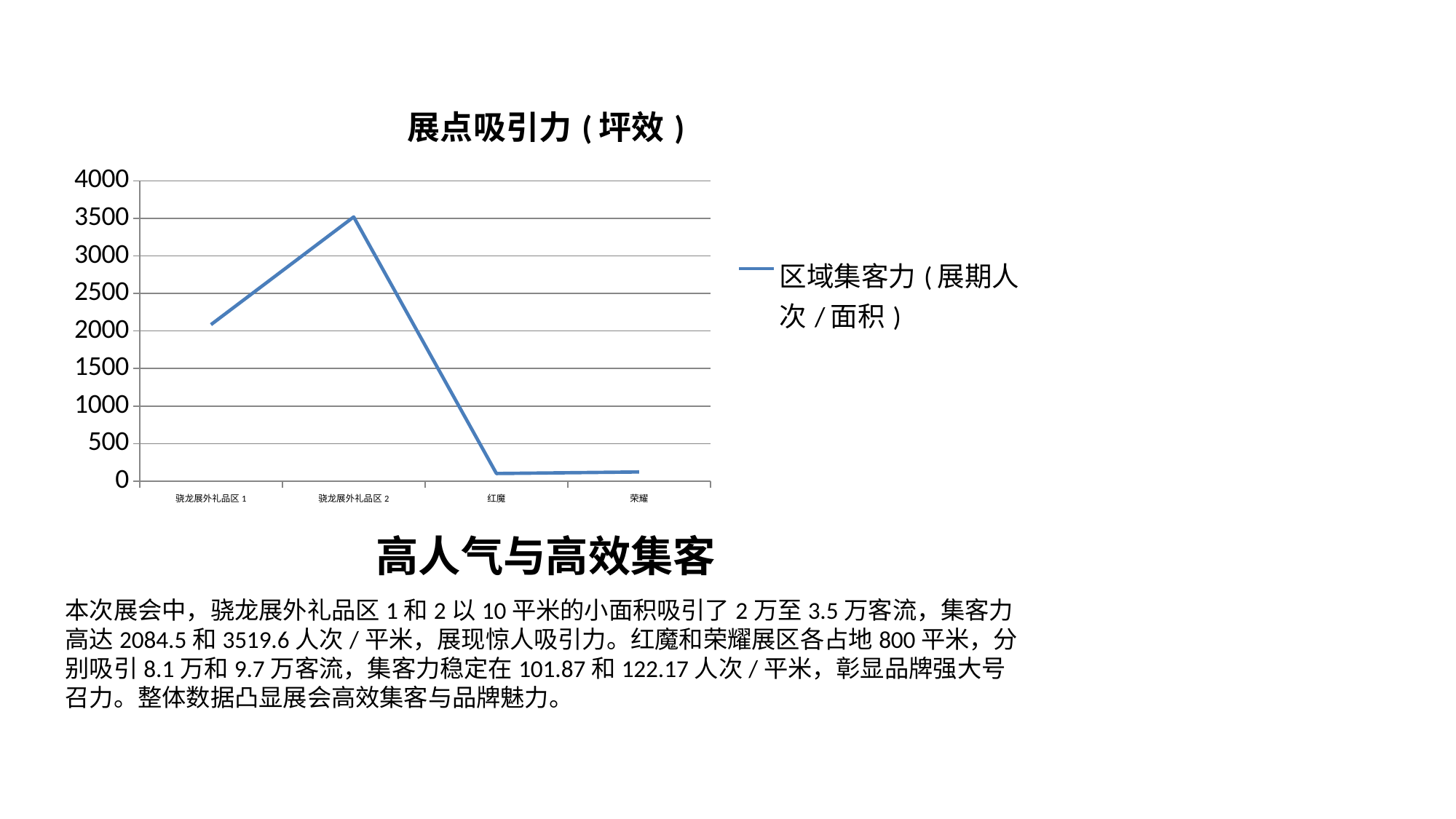
Is the value for 荣耀 greater or less than 1000? less What is the legend entry for the plotted series? 区域集客力（展期人次／面积） Is the value for 骁龙展外礼品区 1 greater or less than 1500? greater Which is larger, the value for 骁龙展外礼品区 1 or 骁龙展外礼品区 2? 骁龙展外礼品区 2 Is the value for 骁龙展外礼品区 2 greater or less than 3000? greater Which category has the highest value? 骁龙展外礼品区 2 Does the line rise or fall from 骁龙展外礼品区 2 to 红魔? fall What kind of chart is shown on the slide? line chart What is the title of the chart? 展点吸引力（坪效） How many series does the legend list? 1 How many categories are plotted on the x axis? 4